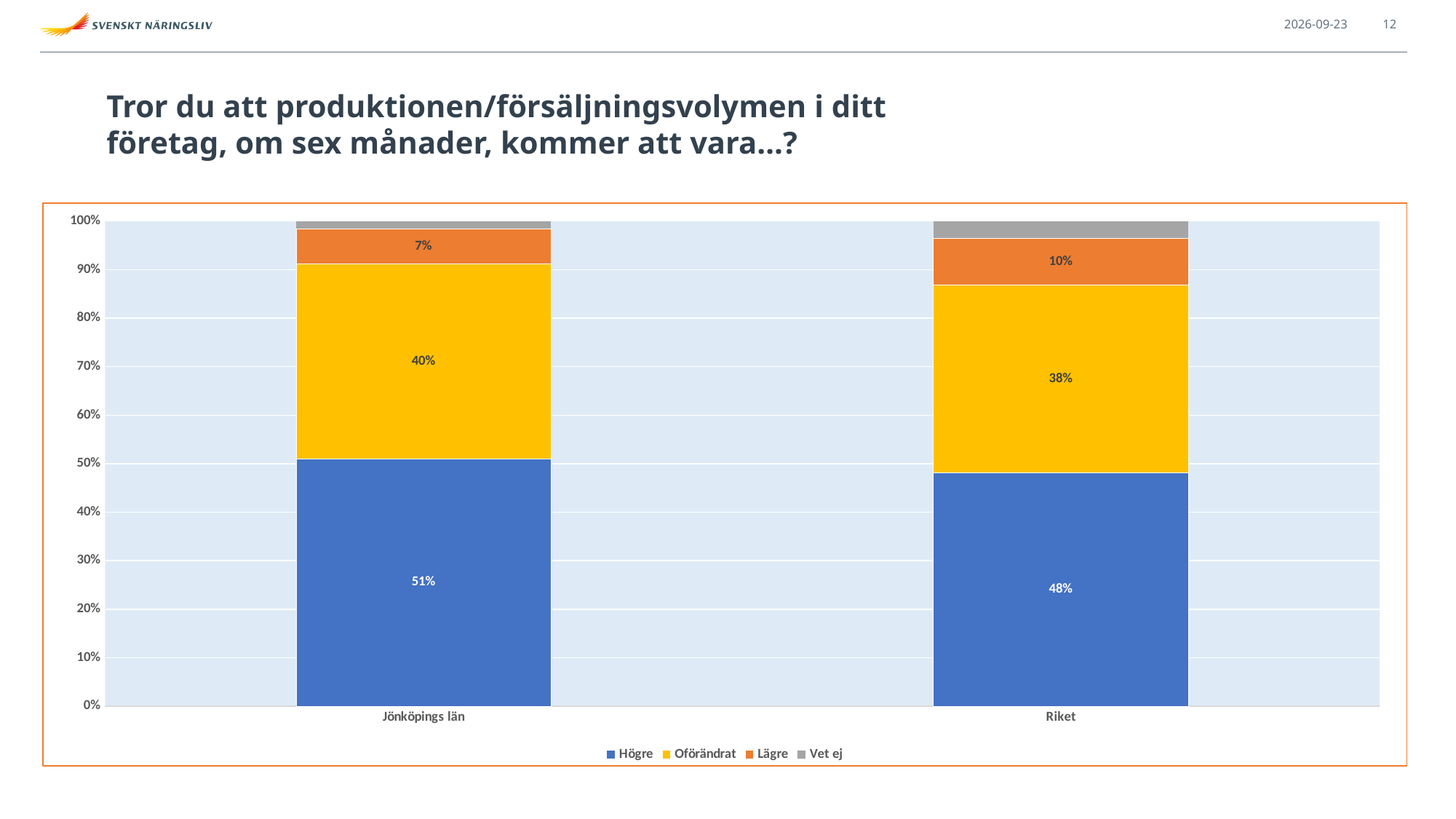
What is the difference in percentage points between the Oförändrat values for Jönköpings län and Riket? 2 percentage points What is the value for Lägre in Jönköpings län? 7% What is the value for Lägre in Riket? 10% How many categories are shown on the x axis? 2 What kind of chart is shown on the slide? Stacked bar chart What is the value for Oförändrat in Riket? 38% Which category has the higher value for Lägre, Jönköpings län or Riket? Riket What is the difference in percentage points between the Högre values for Jönköpings län and Riket? 3 percentage points Is the Vet ej value for Riket greater or less than 10%? less How many series does the legend list? 4 What percentage of respondents in Jönköpings län answered Högre? 51% Which category has the higher value for Högre, Jönköpings län or Riket? Jönköpings län